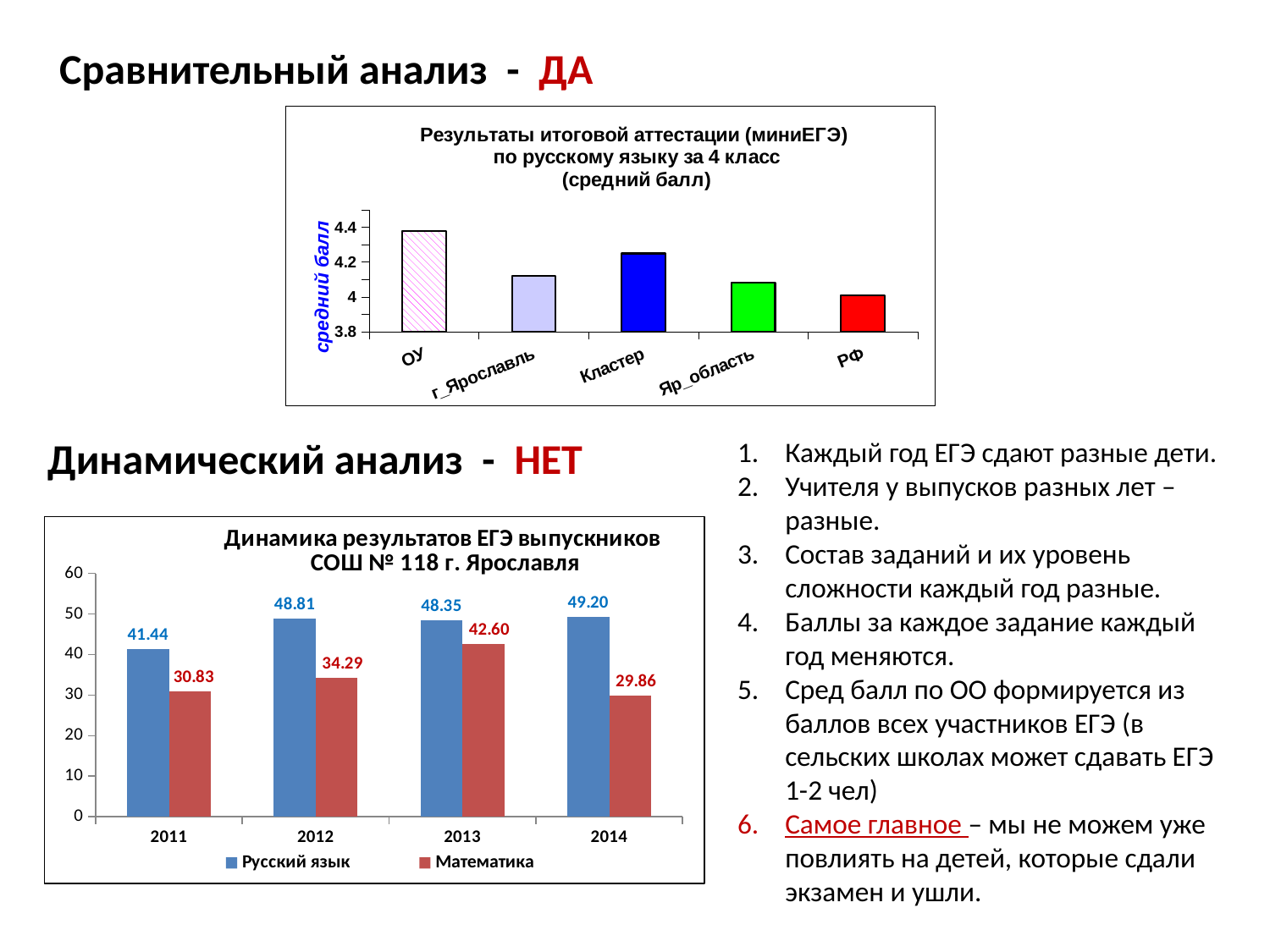
In the bottom chart (Динамика результатов ЕГЭ), what is the value for Русский язык in 2012? 48.81 In the top chart (Результаты итоговой аттестации), how many categories are shown on the x axis? 5 In the top chart (Результаты итоговой аттестации), which is larger, the value for Кластер or the value for г_Ярославль? Кластер In the bottom chart (Динамика результатов ЕГЭ), what is the value for Математика in 2013? 42.60 In the bottom chart (Динамика результатов ЕГЭ), in which year is the Математика value lowest? 2014 In the top chart (Результаты итоговой аттестации), is the value for ОУ greater or less than 4.2? greater In the bottom chart (Динамика результатов ЕГЭ), what is the difference between the Русский язык and Математика values in 2011? 10.61 In the bottom chart (Динамика результатов ЕГЭ), how many series does the legend list? 2 In the top chart (Результаты итоговой аттестации), which category has the highest average score? ОУ In the bottom chart (Динамика результатов ЕГЭ), in which year is the Русский язык value highest? 2014 What type of chart is the bottom chart (Динамика результатов ЕГЭ)? Bar chart In the top chart (Результаты итоговой аттестации), is the value for г_Ярославль greater or less than 4.2? less